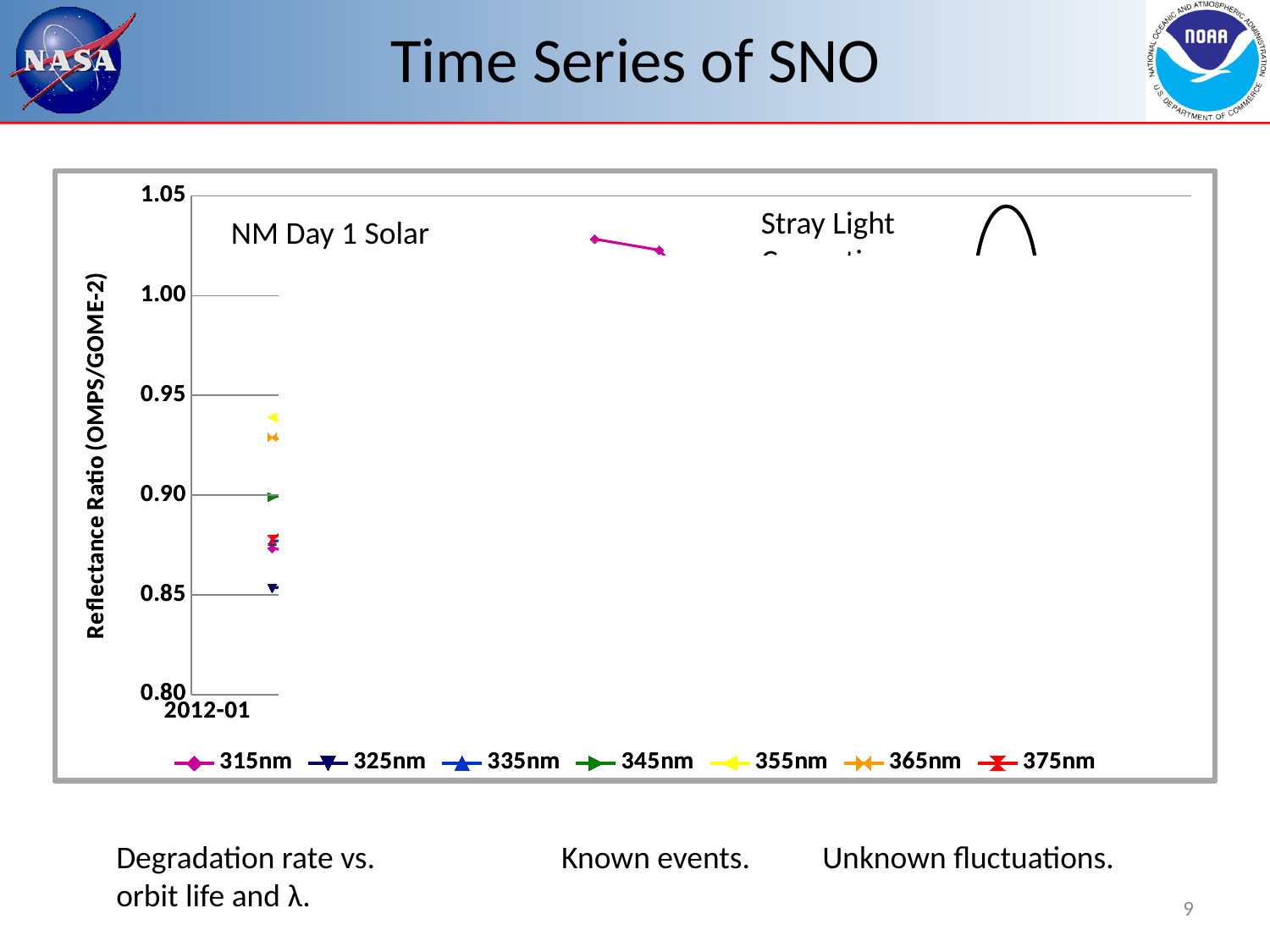
Is the value for 345nm at 2012-01 greater or less than 0.95? less At 2012-01, which series has the lowest reflectance ratio? 325nm What is the title of the vertical axis? Reflectance Ratio (OMPS/GOME-2) How many series does the legend list? 7 What kind of chart is shown on the slide? line chart Is the value for 315nm at 2012-01 greater or less than 0.90? less What is the date label shown on the horizontal axis? 2012-01 Is the value for 325nm at 2012-01 greater or less than 0.90? less At 2012-01, which series has the higher value, 345nm or 375nm? 345nm At 2012-01, which series has the higher value, 355nm or 325nm? 355nm